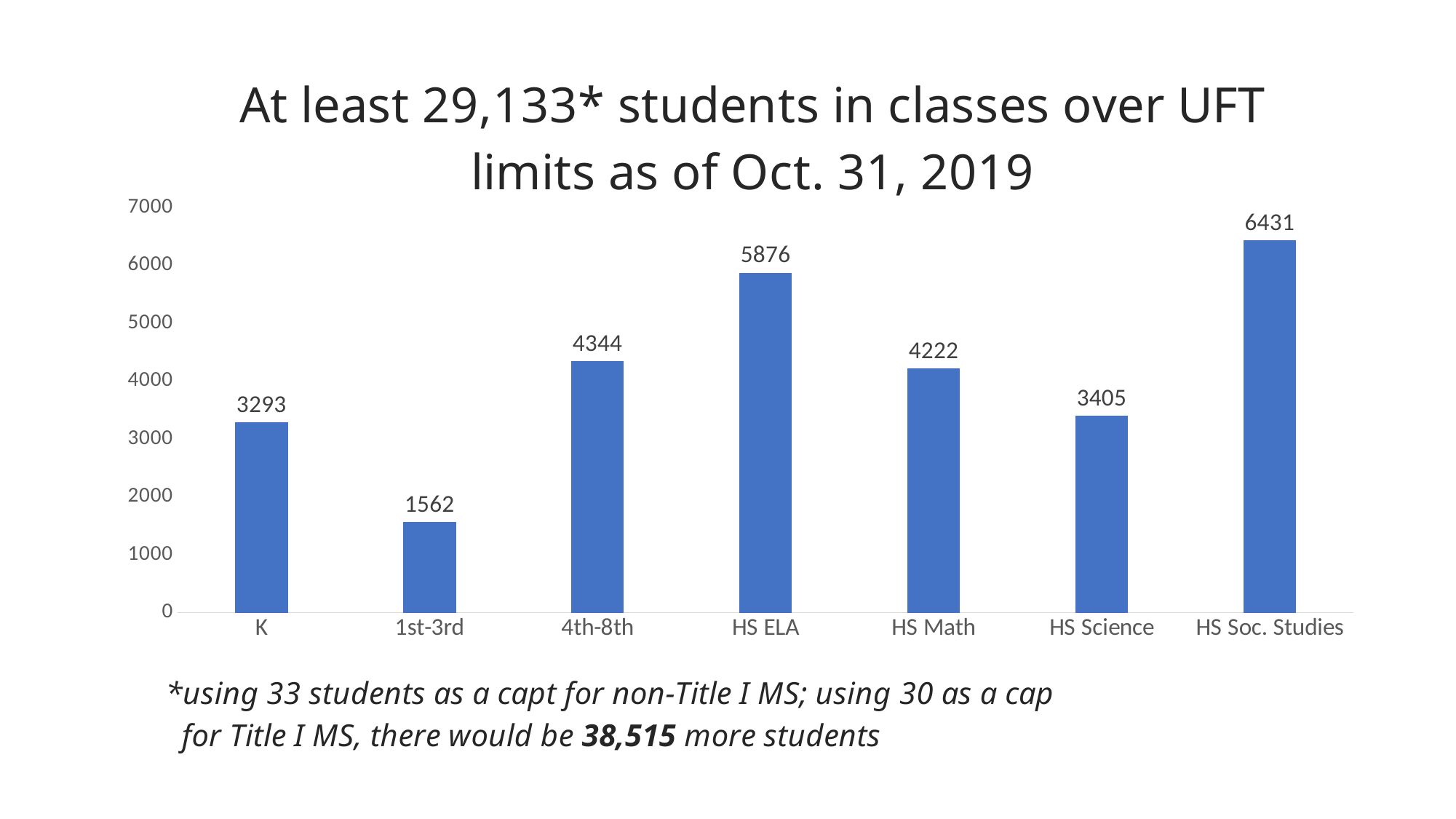
Is the value for HS Math greater or less than 4000? greater What is the value for HS Science? 3405 Which category has the highest value? HS Soc. Studies What is the difference between the values for HS Soc. Studies and HS ELA? 555 How many categories are shown on the x axis? 7 What is the value for 1st-3rd? 1562 Which category has the lowest value? 1st-3rd What is the value for HS ELA? 5876 Which is larger, the value for K or the value for HS Science? HS Science What is the title of the chart? At least 29,133* students in classes over UFT limits as of Oct. 31, 2019 What kind of chart is shown on the slide? bar chart What is the difference between the values for 4th-8th and HS Math? 122